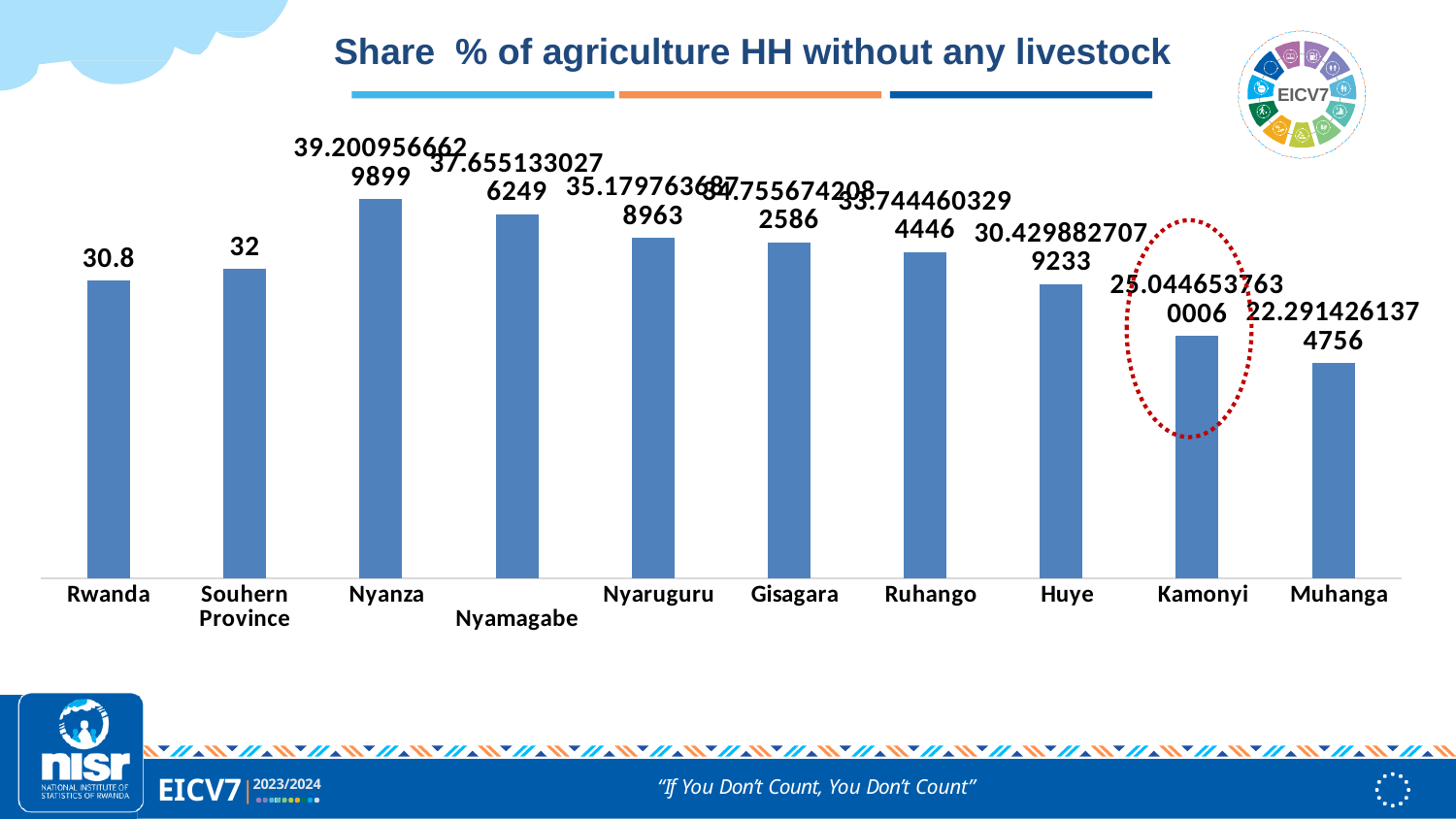
What is the value for Souhern Province? 32 What is the value for Huye? 30.4298827079233 What is the value for Rwanda? 30.8 What is the value for Kamonyi? 25.0446537630006 Which is larger, the value for Kamonyi or the value for Muhanga? Kamonyi What is the value for Muhanga? 22.2914261374756 How many categories are shown on the x axis? 10 Which category's bar is highlighted with a red dotted circle? Kamonyi What kind of chart is shown on the slide? Bar chart What is the difference between the values for Souhern Province and Rwanda? 1.2 Which category has the highest value? Nyanza Which category has the lowest value? Muhanga